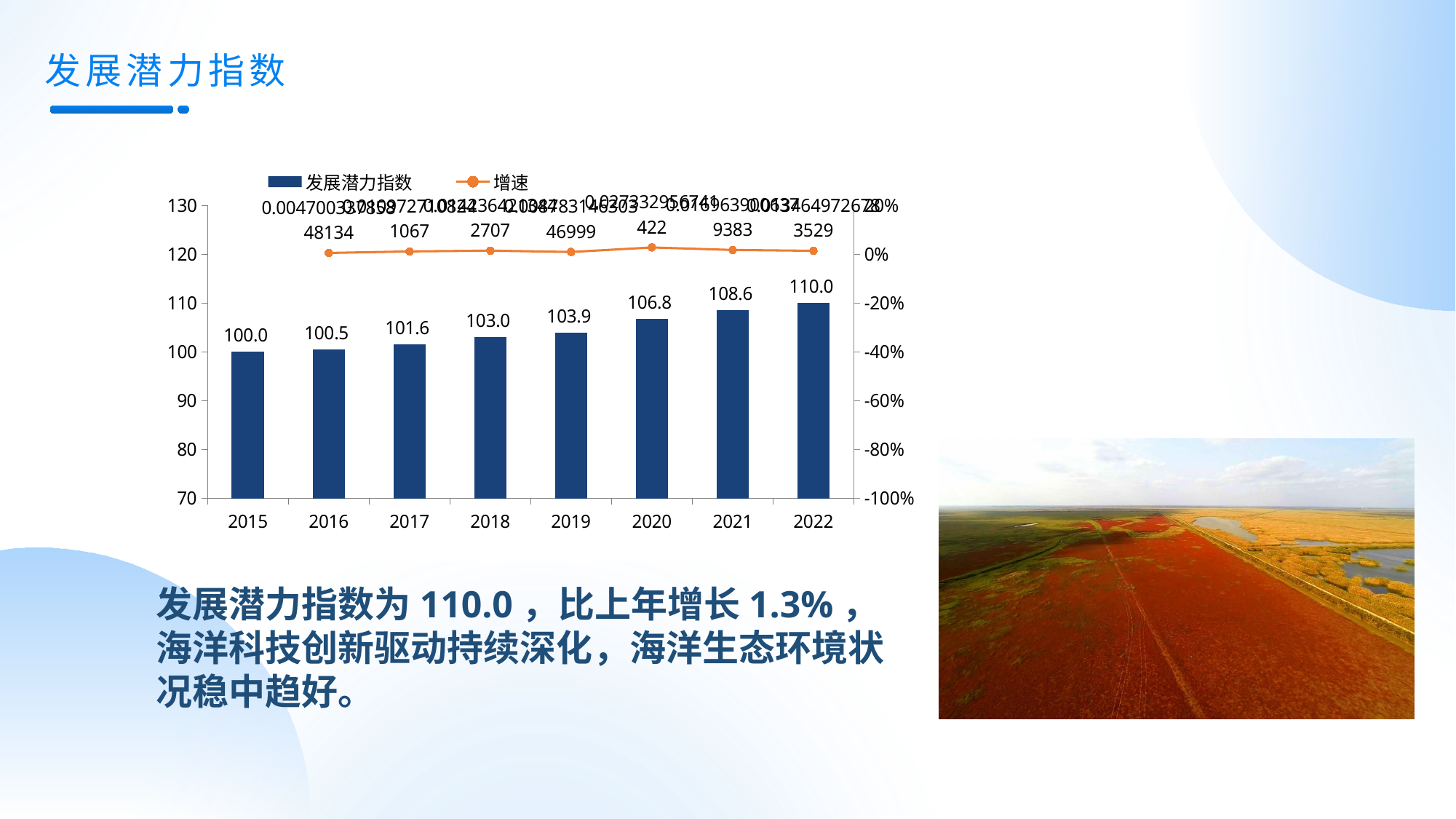
Which year has a larger 发展潜力指数 value, 2018 or 2020? 2020 What is the difference between the 发展潜力指数 values for 2021 and 2020? 1.8 What is the 发展潜力指数 value for 2022? 110.0 What is the 发展潜力指数 value for 2019? 103.9 How many series does the legend list? 2 Which year has the highest 发展潜力指数 value? 2022 What is the 发展潜力指数 value for 2015? 100.0 Which year has the lowest 发展潜力指数 value? 2015 What are the two series named in the chart legend? 发展潜力指数 and 增速 What is the difference between the 发展潜力指数 values for 2022 and 2015? 10.0 How many years are shown on the x axis of the chart? 8 Do the 发展潜力指数 bar values rise or fall from 2015 to 2022? rise